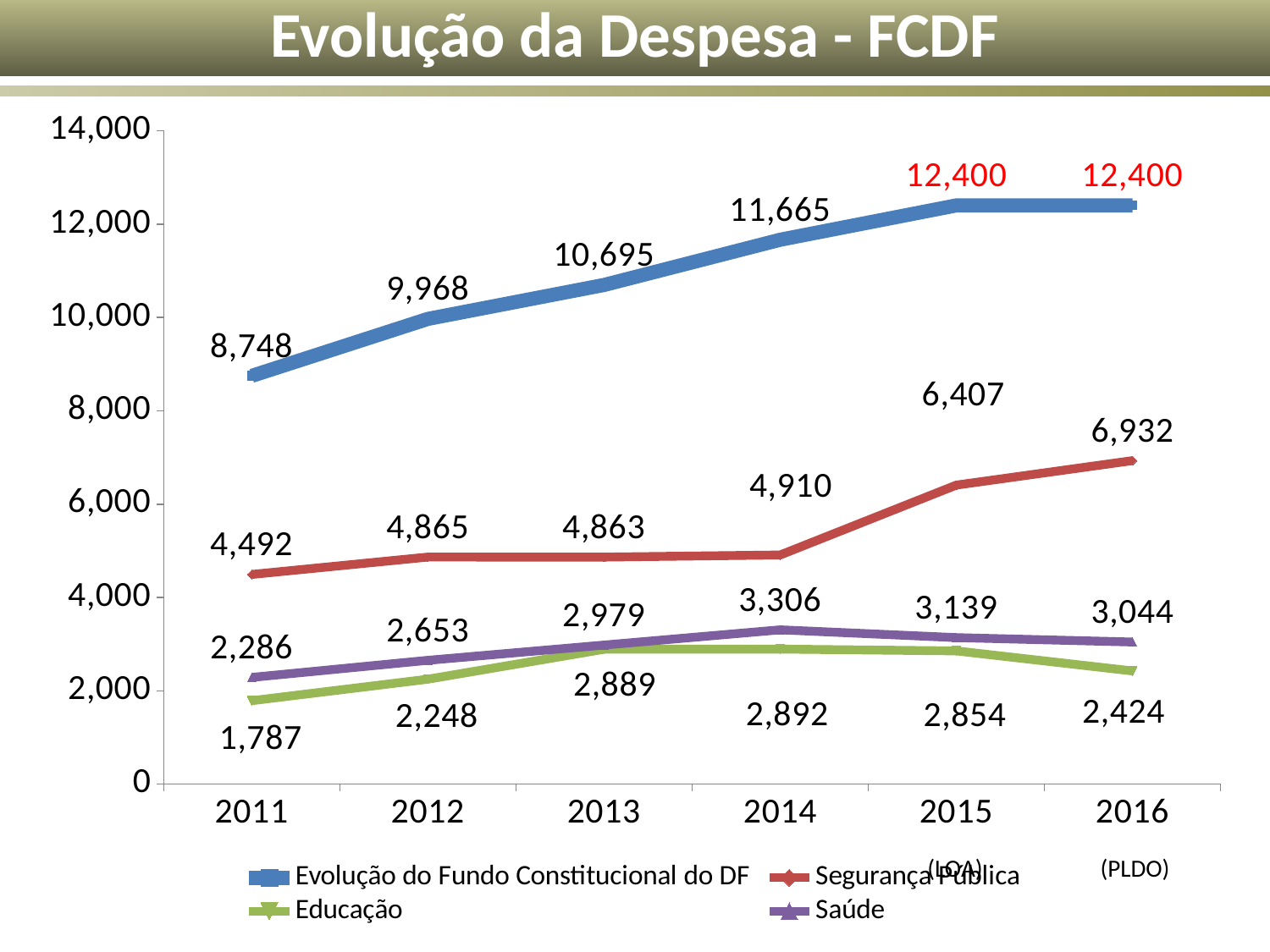
What type of chart is shown on the slide? Line chart Which is larger in 2016, the value for Saúde or the value for Educação? Saúde What is the value for Evolução do Fundo Constitucional do DF in 2013? 10,695 In which year is the Saúde series highest? 2014 What is the value for Educação in 2011? 1,787 Does the Evolução do Fundo Constitucional do DF series rise or fall from 2011 to 2015? Rise How many series does the legend list? 4 What is the difference between the Evolução do Fundo Constitucional do DF values in 2015 and 2011? 3,652 In which year is the Segurança Pública series lowest? 2011 What is the value for Saúde in 2014? 3,306 What is the value for Segurança Pública in 2016? 6,932 How many years are shown on the x axis? 6